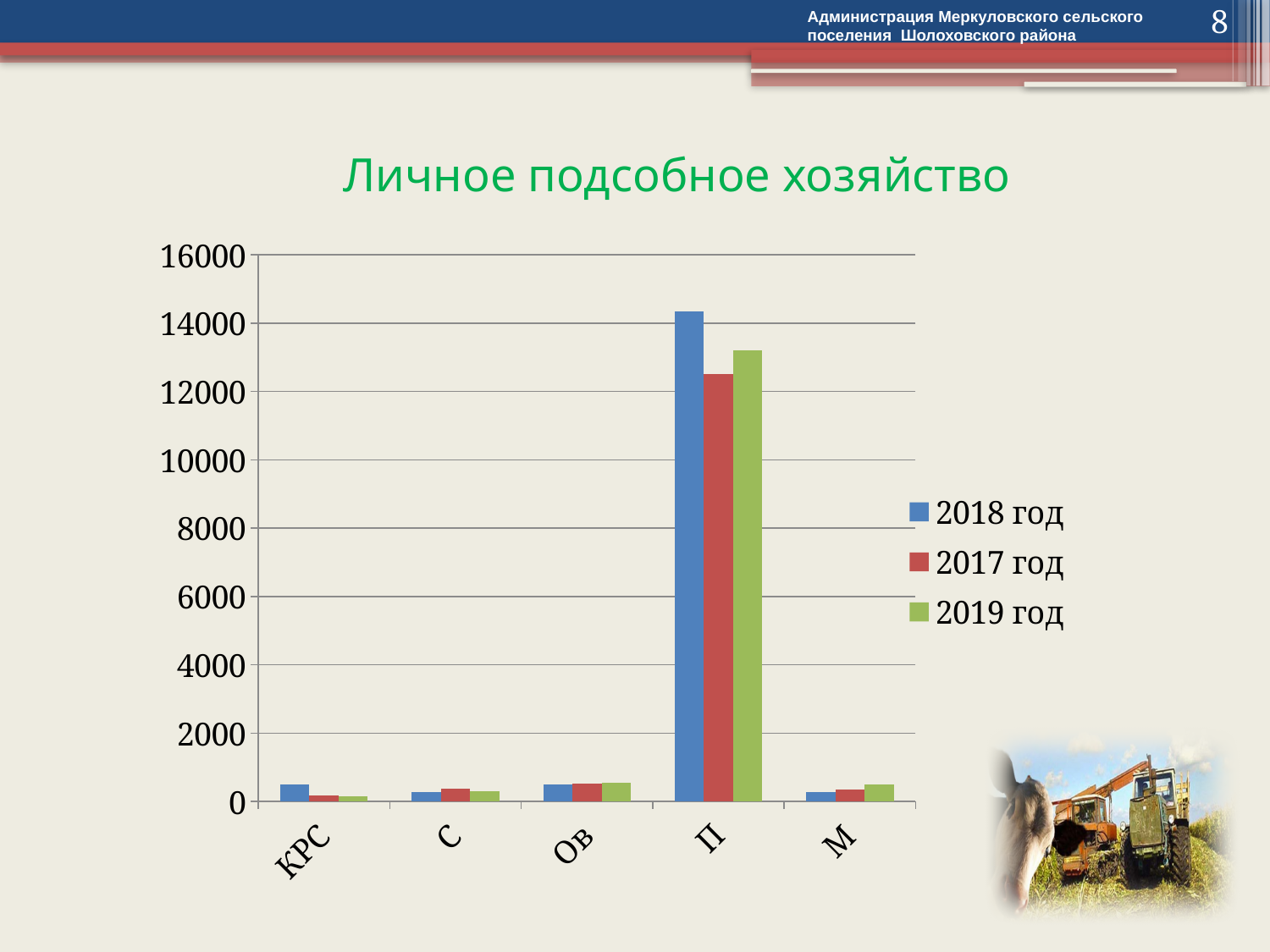
Which category has the highest values in the chart? П What kind of chart is shown on the slide? bar chart What is the title of the chart? Личное подсобное хозяйство Is the value for КРС in 2018 год greater or less than 2000? less For category П, which is larger: the value for 2019 год or the value for 2017 год? 2019 год Is the value for П in 2018 год greater or less than 14000? greater Is the value for П in 2017 год greater or less than 14000? less Which series is shown in green in the legend? 2019 год For category П, which is larger: the value for 2018 год or the value for 2017 год? 2018 год How many categories are shown on the x axis of the chart? 5 How many series does the legend list? 3